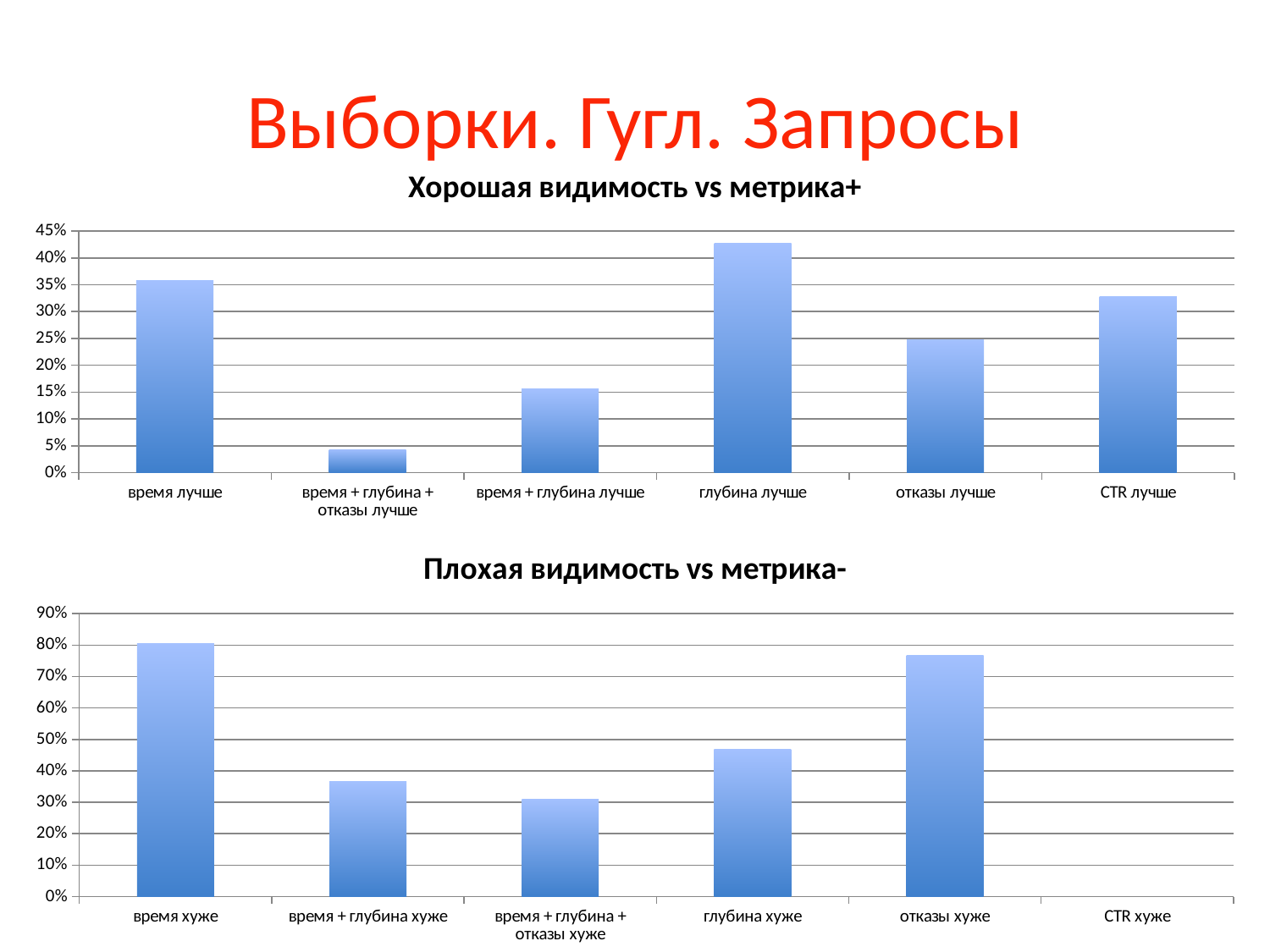
In the bottom chart 'Плохая видимость vs метрика-', is the value for 'глубина хуже' greater or less than 40%? greater In the top chart 'Хорошая видимость vs метрика+', which category has the lowest value? время + глубина + отказы лучше What is the title of the bottom chart on the slide? Плохая видимость vs метрика- In the bottom chart 'Плохая видимость vs метрика-', which category has no visible bar? CTR хуже In the top chart 'Хорошая видимость vs метрика+', which is larger: 'время лучше' or 'CTR лучше'? время лучше In the bottom chart 'Плохая видимость vs метрика-', which category has the highest value? время хуже In the top chart 'Хорошая видимость vs метрика+', which category has the highest value? глубина лучше What kind of chart is the top chart titled 'Хорошая видимость vs метрика+'? bar chart In the top chart 'Хорошая видимость vs метрика+', is the value for 'глубина лучше' greater or less than 40%? greater In the top chart 'Хорошая видимость vs метрика+', is the value for 'отказы лучше' greater or less than 30%? less In the top chart 'Хорошая видимость vs метрика+', how many categories are shown on the x axis? 6 In the bottom chart 'Плохая видимость vs метрика-', which is larger: 'время + глубина хуже' or 'время + глубина + отказы хуже'? время + глубина хуже